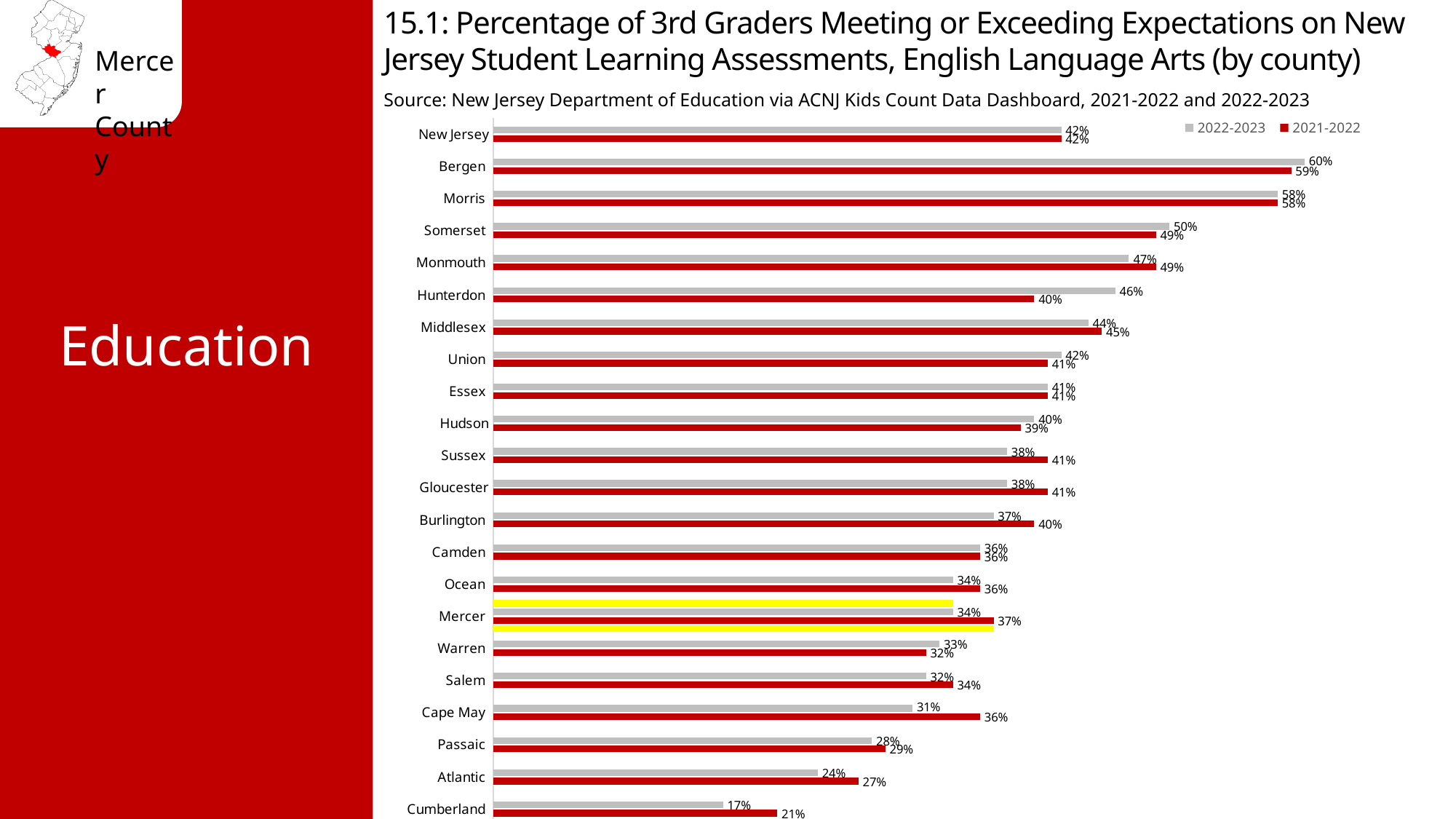
Which county has the highest 2022-2023 value? Bergen Which county has the lowest 2021-2022 value? Cumberland What is the 2022-2023 value for Mercer? 34% What is the 2022-2023 value for Cumberland? 17% How many series does the legend list? 2 What type of chart is shown on the slide? bar chart Which is larger for Cape May: the 2022-2023 value or the 2021-2022 value? 2021-2022 What is the difference between the 2022-2023 and 2021-2022 values for Hunterdon? 6% How many categories (counties plus New Jersey) are shown on the chart? 22 What is the difference between the 2021-2022 values for Bergen and Cumberland? 38% Which series is shown in red in the legend? 2021-2022 What is the 2021-2022 value for Hunterdon? 40%